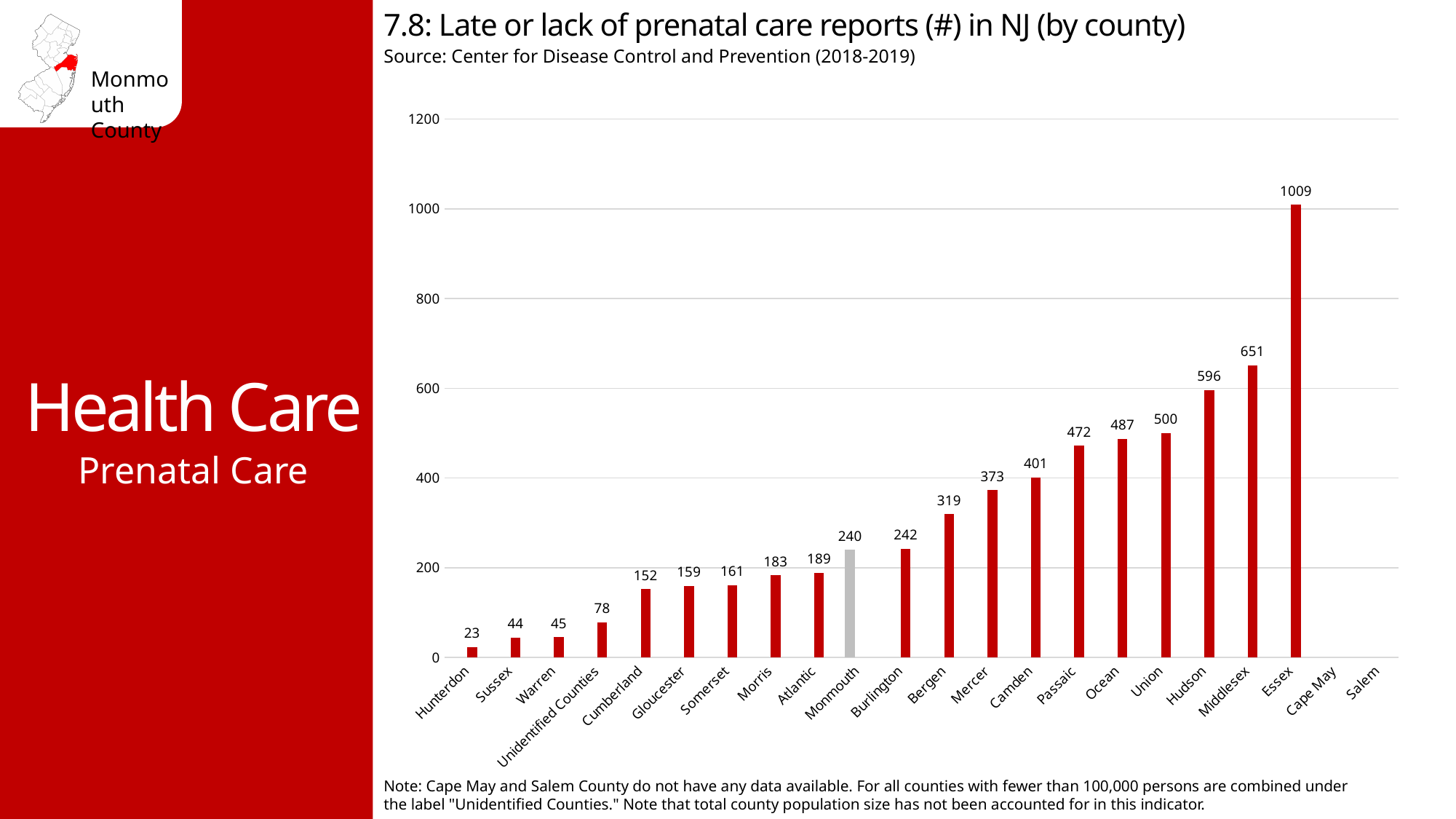
What is the value shown for Essex? 1009 What is the difference between the values for Essex and Middlesex? 358 What is the number of late or lack of prenatal care reports for Monmouth? 240 Which bar is coloured grey instead of red? Monmouth Which county has the highest number of late or lack of prenatal care reports? Essex How many categories are shown on the x axis? 22 Is the value for Passaic greater or less than 400? greater Do the values generally rise or fall from left to right along the x axis? Rise What kind of chart is this? Bar chart Which has a higher value, Hudson or Union? Hudson What is the value shown for Hunterdon? 23 Which labelled county has the lowest number of reports? Hunterdon